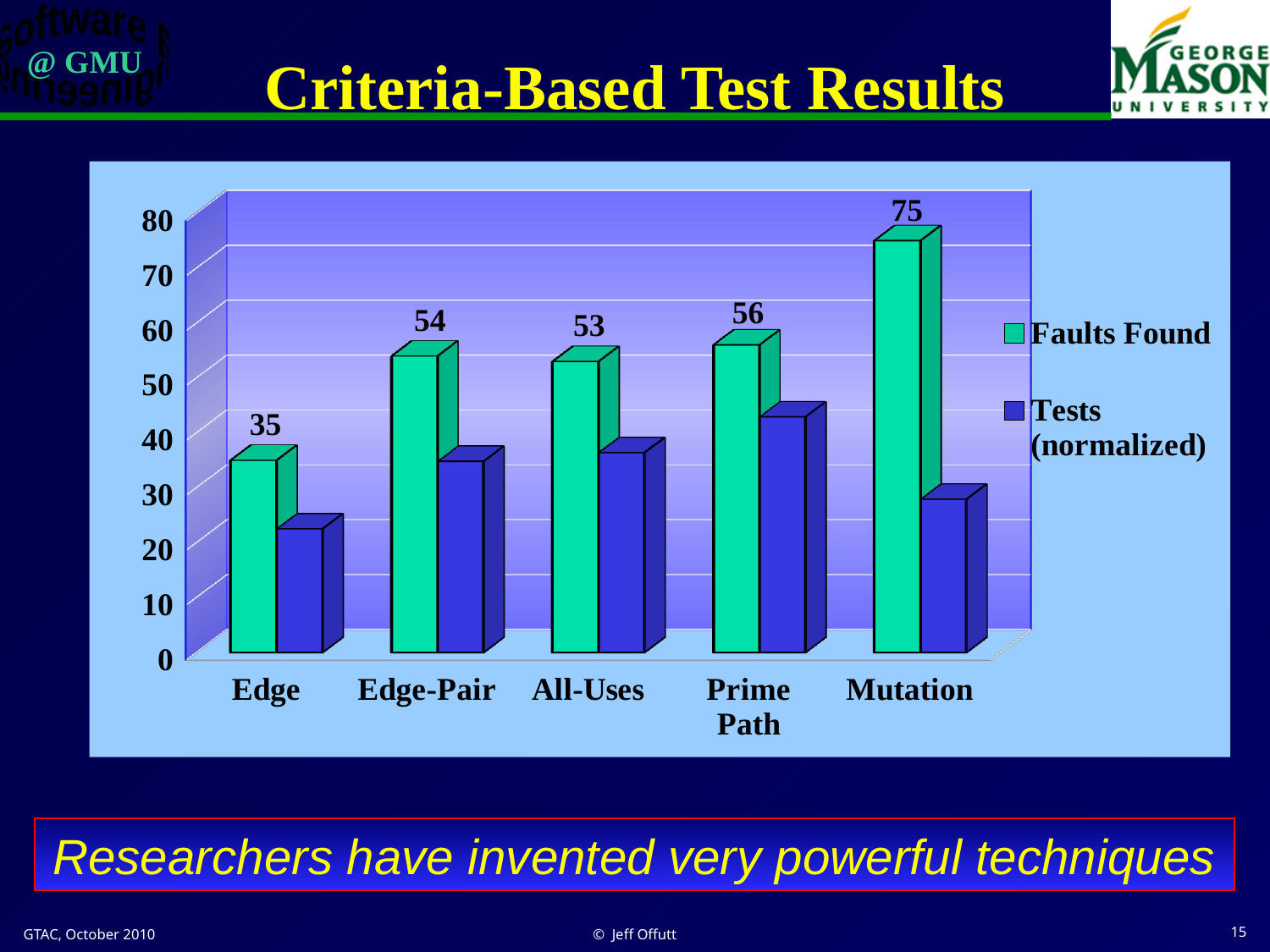
Which criterion has the lowest Faults Found value? Edge Which criterion has the highest Faults Found value? Mutation What is the Faults Found value for Edge-Pair? 54 Which has a higher Faults Found value, Edge-Pair or All-Uses? Edge-Pair Which criterion has the highest Tests (normalized) value? Prime Path What is the difference between the Faults Found values for Mutation and Edge? 40 Is the Tests (normalized) value for Mutation greater or less than 40? less How many series does the legend list? 2 What is the Faults Found value for Prime Path? 56 How many criteria are shown on the x axis? 5 What is the Faults Found value for Mutation? 75 Is the Tests (normalized) value for Edge greater or less than 30? less